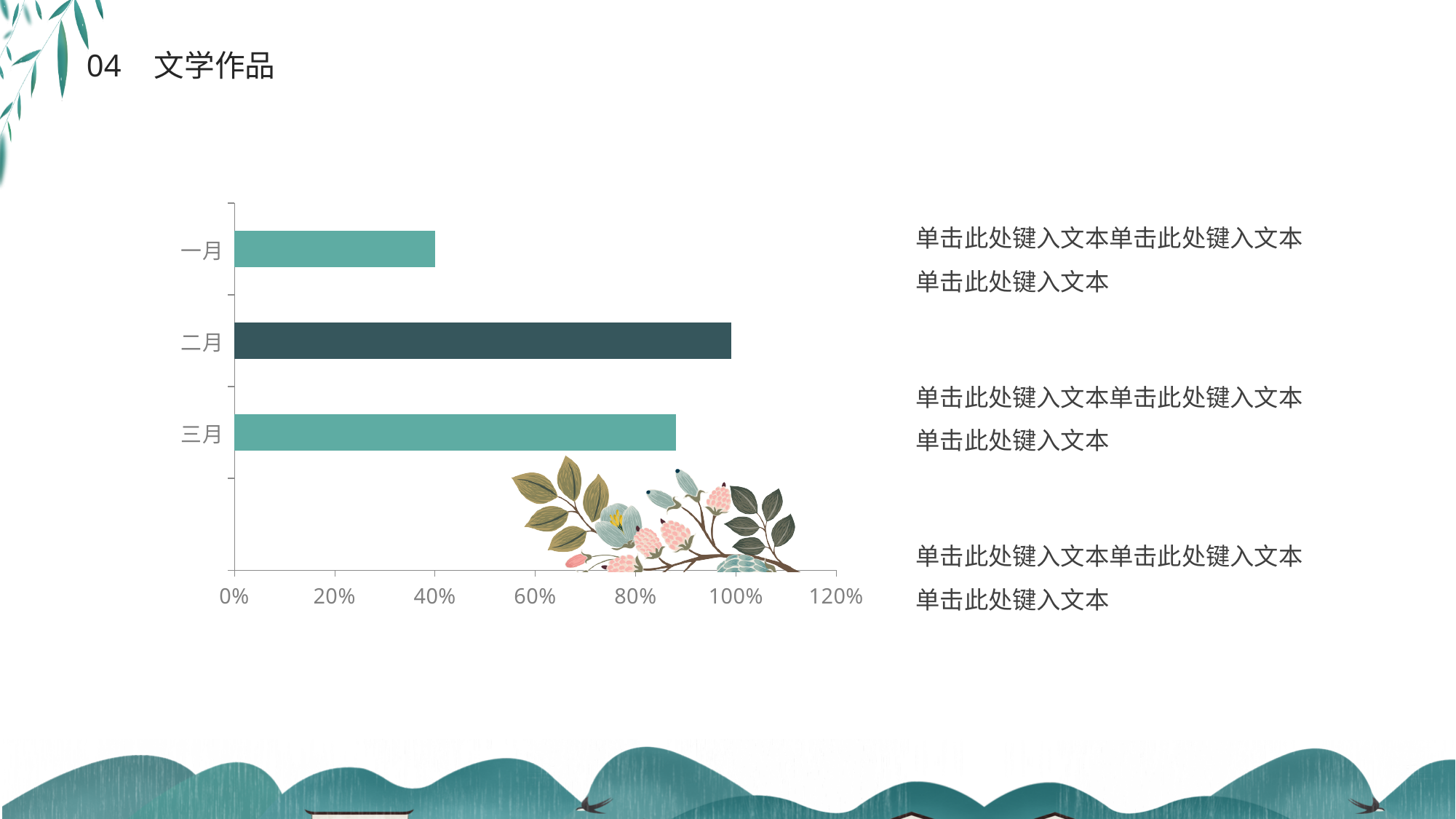
How many categories does the bar chart show? 3 Which category has the highest value in the bar chart? 二月 Is the value for 三月 greater or less than 100%? less What is the highest tick label shown on the horizontal axis of the bar chart? 120% Is the value for 一月 greater or less than 60%? less Which has a larger value, 二月 or 三月? 二月 Is the value for 三月 greater or less than 80%? greater Which has a larger value, 一月 or 三月? 三月 Which category has the lowest value in the bar chart? 一月 What kind of chart is shown on the slide? bar chart What is the value for 一月 in the bar chart? 40%